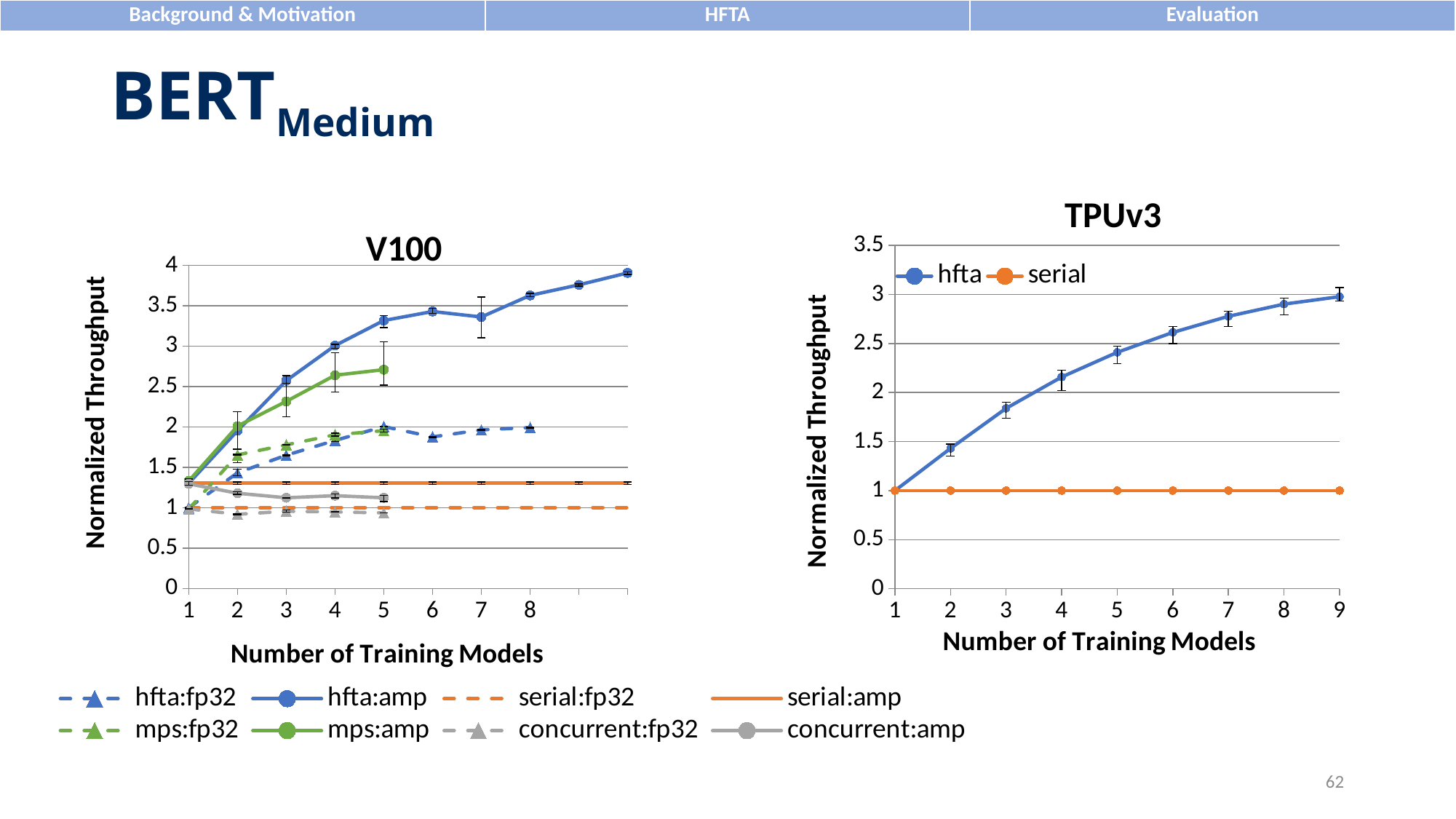
In the V100 chart, at 5 training models, which is larger: hfta:amp or mps:amp? hfta:amp What kind of chart is the V100 chart? line chart In the TPUv3 chart, what is the normalized throughput of the serial series? 1 In the V100 chart, is the value for hfta:amp at 8 training models greater or less than 3.5? greater In the V100 chart, which series reaches the highest normalized throughput? hfta:amp In the TPUv3 chart, how many numbers of training models are plotted on the x axis? 9 In the TPUv3 chart, is the value for hfta at 9 training models greater or less than 2.5? greater In the TPUv3 chart, does the hfta series rise or fall as the number of training models increases? rises How many series does the legend of the V100 chart list? 8 In the V100 chart, is the value for mps:amp at 5 training models greater or less than 2.5? greater What is the y-axis label of the TPUv3 chart? Normalized Throughput How many series does the legend of the TPUv3 chart list? 2